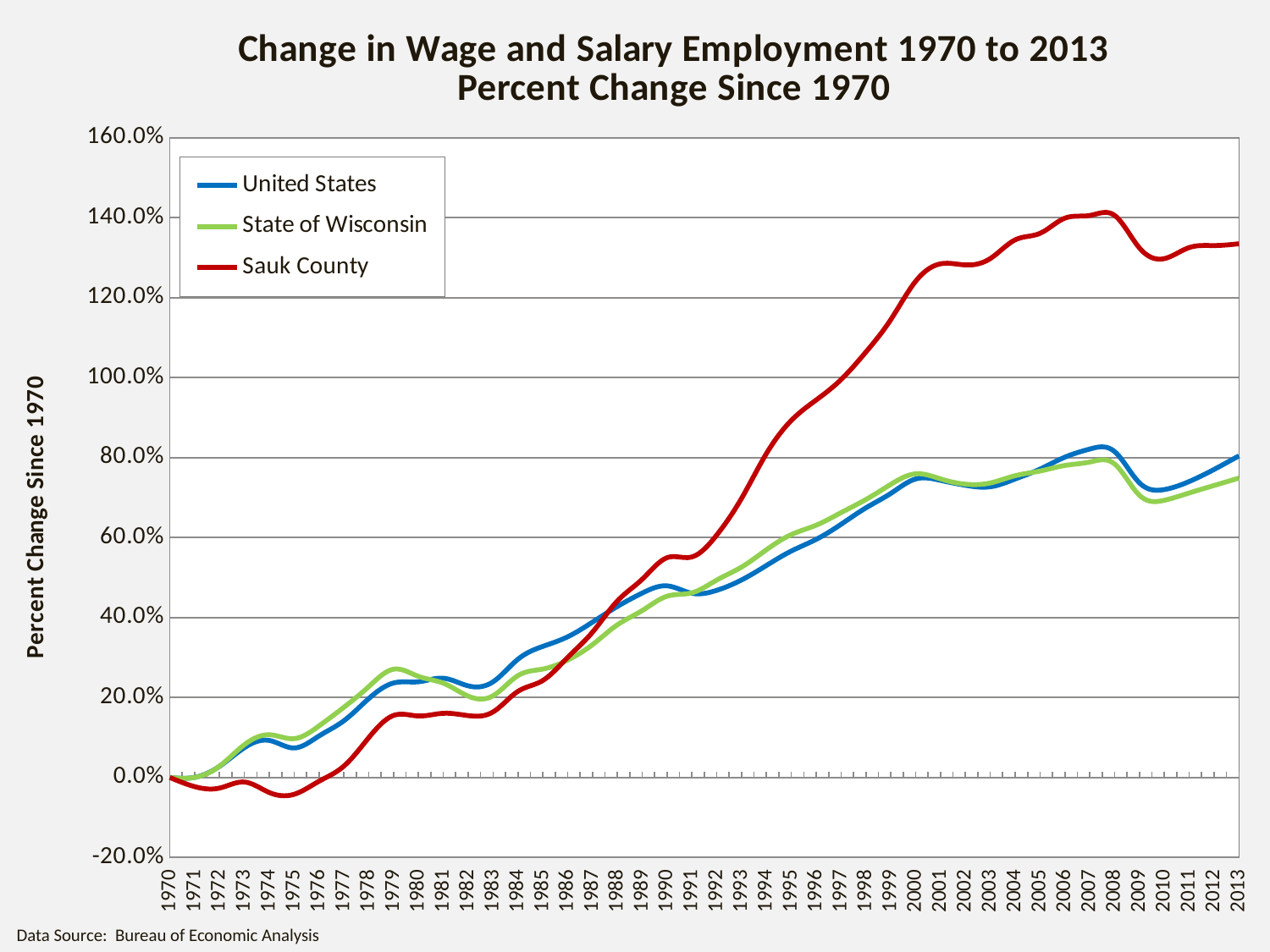
How many years are plotted along the x axis? 44 In 2013, which is larger: the value for Sauk County or the value for United States? Sauk County Is the value for United States in 2013 greater or less than 100.0%? less Is the value for State of Wisconsin in 2010 greater or less than 60.0%? greater What is the label on the y axis? Percent Change Since 1970 How many series does the legend list? 3 Is the value for Sauk County in 2013 greater or less than 120.0%? greater What kind of chart is shown on the slide? Line chart Which series has the lowest value in 1979? Sauk County Which series has the highest value in 2013? Sauk County Does the Sauk County line rise or fall between 1990 and 2007? Rise